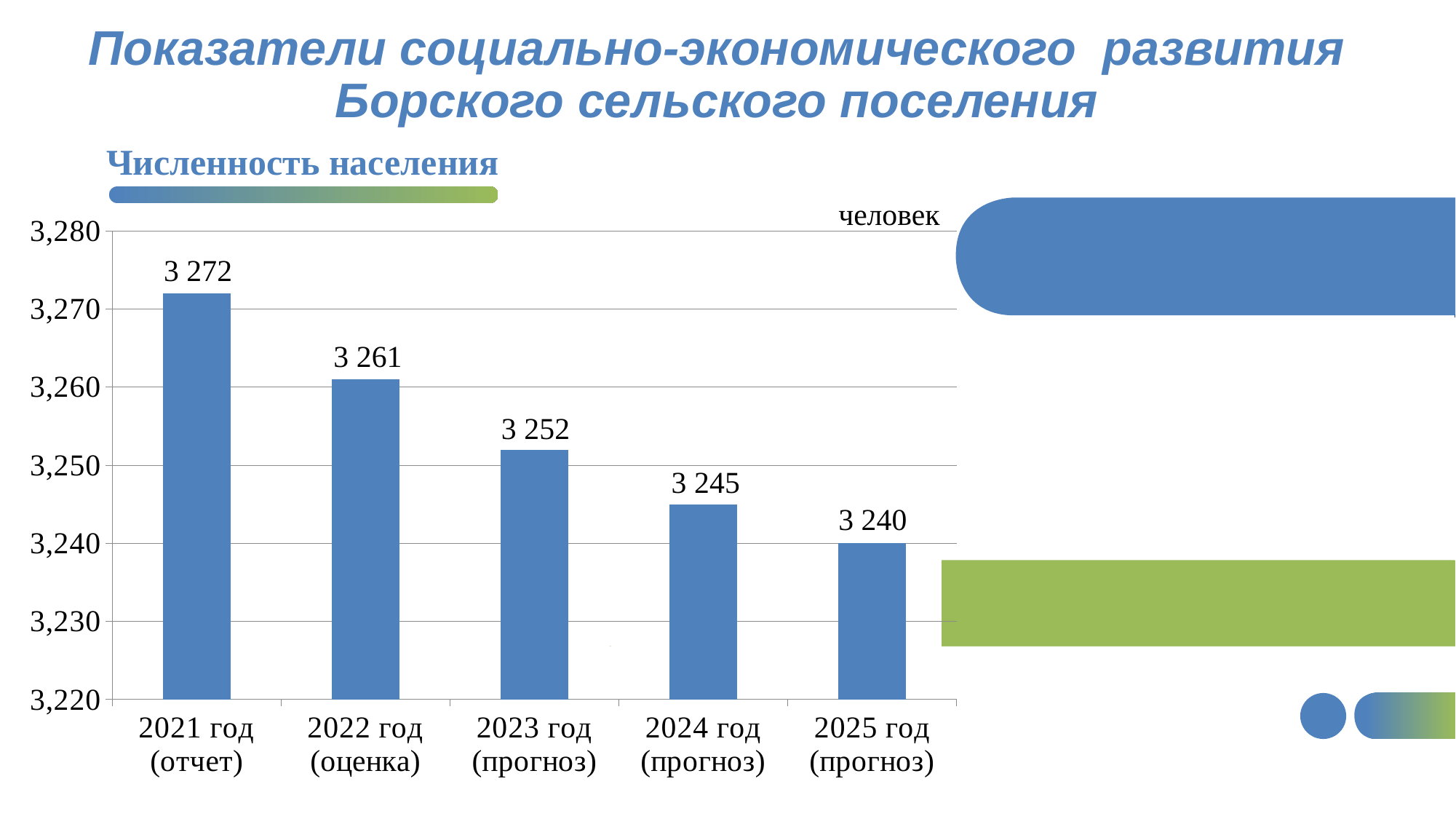
Do the population values rise or fall from 2021 to 2025? fall What is the population value shown for 2025 год (прогноз)? 3 240 Is the value for 2023 год (прогноз) greater or less than 3,260? less What is the difference between the population values for 2022 год (оценка) and 2024 год (прогноз)? 16 Which year has the highest population value? 2021 год (отчет) Which is larger, the value for 2022 год (оценка) or the value for 2024 год (прогноз)? 2022 год (оценка) How many years are shown on the x axis of the chart? 5 What is the population value shown for 2023 год (прогноз)? 3 252 What kind of chart is shown on the slide? bar chart What is the difference between the population values for 2021 год (отчет) and 2025 год (прогноз)? 32 What is the population value shown for 2021 год (отчет)? 3 272 Which year has the lowest population value? 2025 год (прогноз)